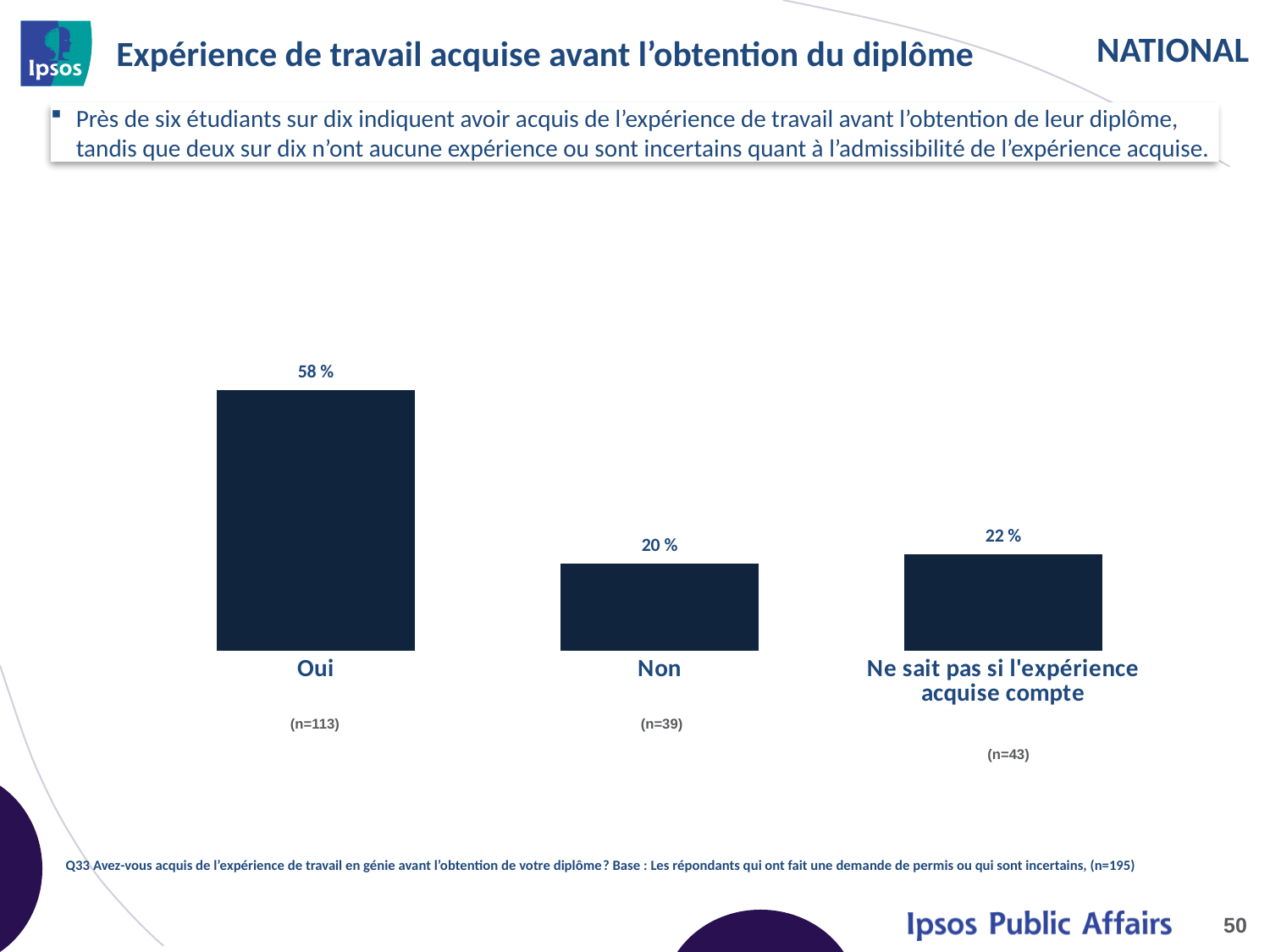
Which category has the lowest value? Non What is the value for "Non"? 20 % How many categories are shown in the chart? 3 What is the title of the slide containing the chart? Expérience de travail acquise avant l'obtention du diplôme What is the sample size (n) shown under the "Non" bar? (n=39) What is the value for "Ne sait pas si l'expérience acquise compte"? 22 % What is the difference between the values for "Ne sait pas si l'expérience acquise compte" and "Non"? 2 % Which is larger, the value for "Oui" or the value for "Ne sait pas si l'expérience acquise compte"? Oui What is the difference between the values for "Oui" and "Non"? 38 % Which category has the highest value? Oui What is the value for "Oui"? 58 % What kind of chart is shown on the slide? Bar chart